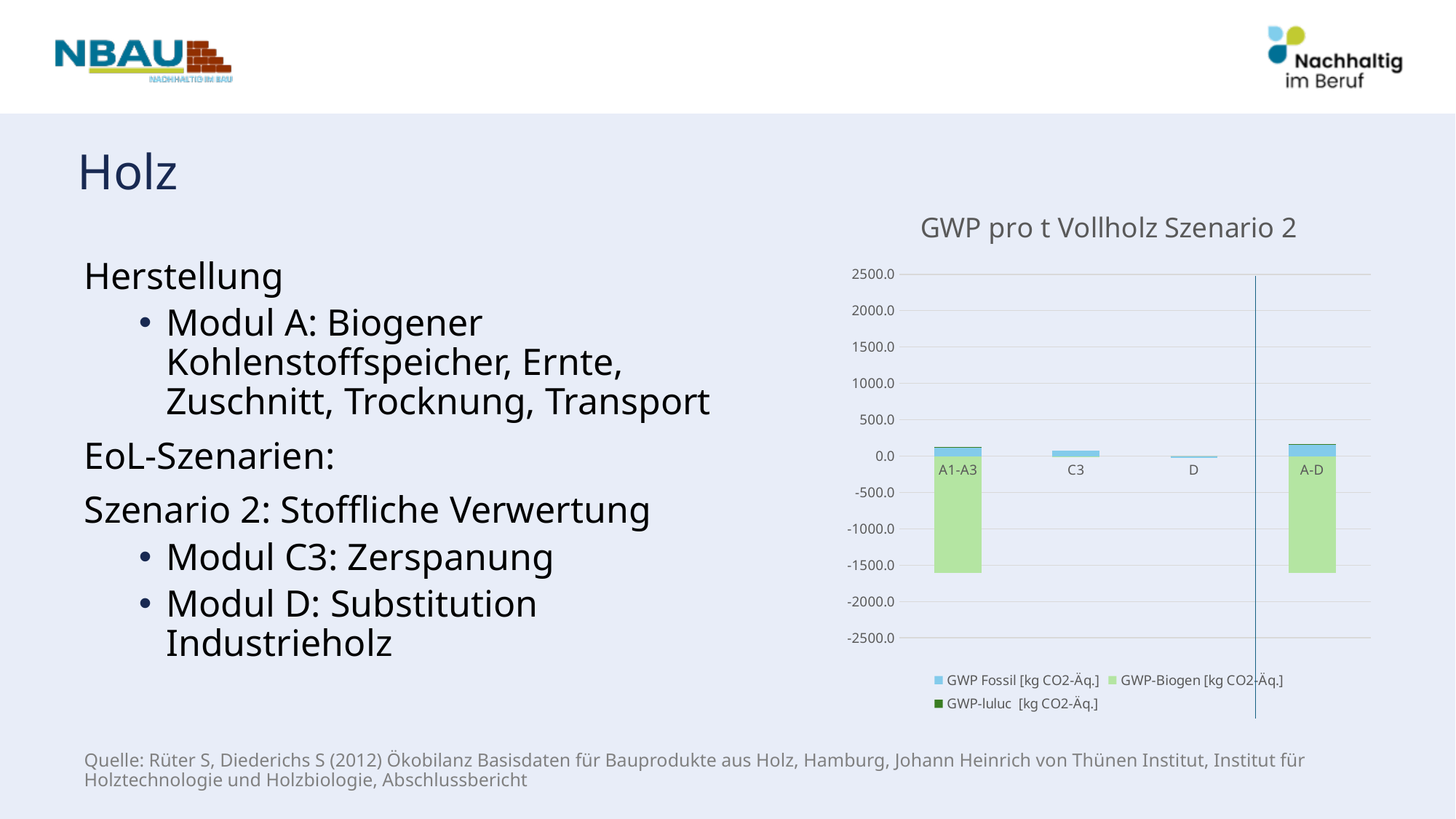
Is the GWP Fossil value for C3 greater or less than 500? less How many series does the chart legend list? 3 What kind of chart is shown on the slide? bar chart Is the GWP-Biogen value for A-D greater or less than -1000? less Which has the larger GWP Fossil value, A1-A3 or C3? A1-A3 Which category has a GWP Fossil bar that extends below zero? D Is the GWP Fossil value for A1-A3 greater or less than 500? less How many categories show a visible GWP-Biogen bar? 2 Which colour represents GWP-Biogen [kg CO2-Äq.] in the chart? green How many categories are shown on the x axis of the chart? 4 What is the title of the chart? GWP pro t Vollholz Szenario 2